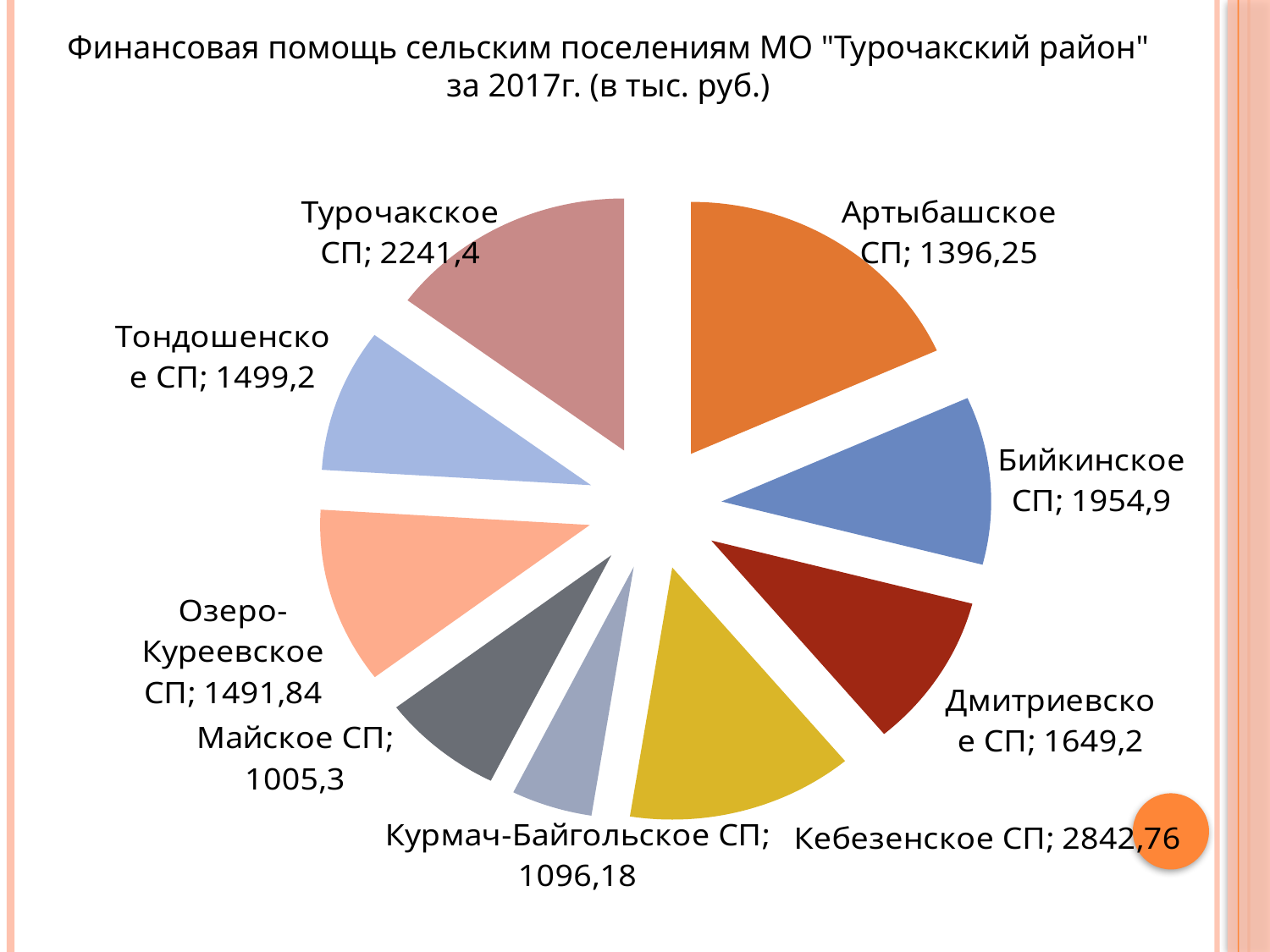
What is the title of the chart? Финансовая помощь сельским поселениям МО "Турочакский район" за 2017г. (в тыс. руб.) Which settlement received the smallest amount of financial assistance? Майское СП Which is larger, the value for Турочакское СП or the value for Бийкинское СП? Турочакское СП What is the value for Кебезенское СП? 2842,76 What is the value for Турочакское СП? 2241,4 Which is larger, the value for Дмитриевское СП or the value for Майское СП? Дмитриевское СП What is the difference between the values for Кебезенское СП and Турочакское СП? 601,36 What kind of chart is shown on the slide? pie chart What is the value for Курмач-Байгольское СП? 1096,18 How many settlements (slices) are shown in the pie chart? 9 What is the difference between the values for Бийкинское СП and Артыбашское СП? 558,65 Which settlement received the largest amount of financial assistance? Кебезенское СП